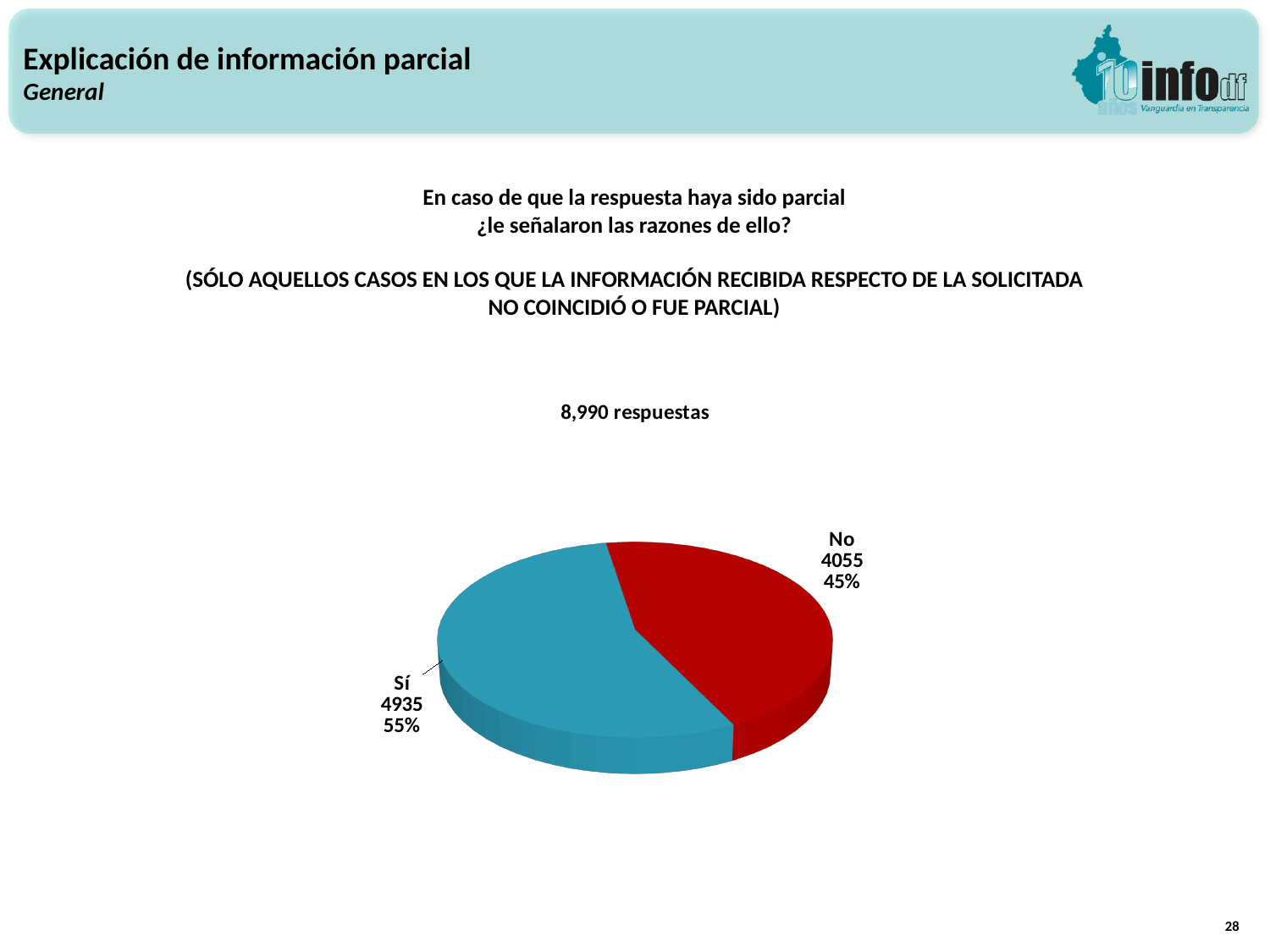
What is the number of responses for "Sí"? 4935 Which slice is the smallest? No What colour is the "No" slice? red Which slice is the largest? Sí What is the number of responses for "No"? 4055 What is the total number of responses shown above the chart? 8,990 respuestas What is the difference in responses between "Sí" and "No"? 880 What share of the pie does the "Sí" slice represent? 55% What kind of chart is shown on the slide? pie chart What share of the pie does the "No" slice represent? 45% How many slices does the pie chart have? 2 Which has more responses, "Sí" or "No"? Sí